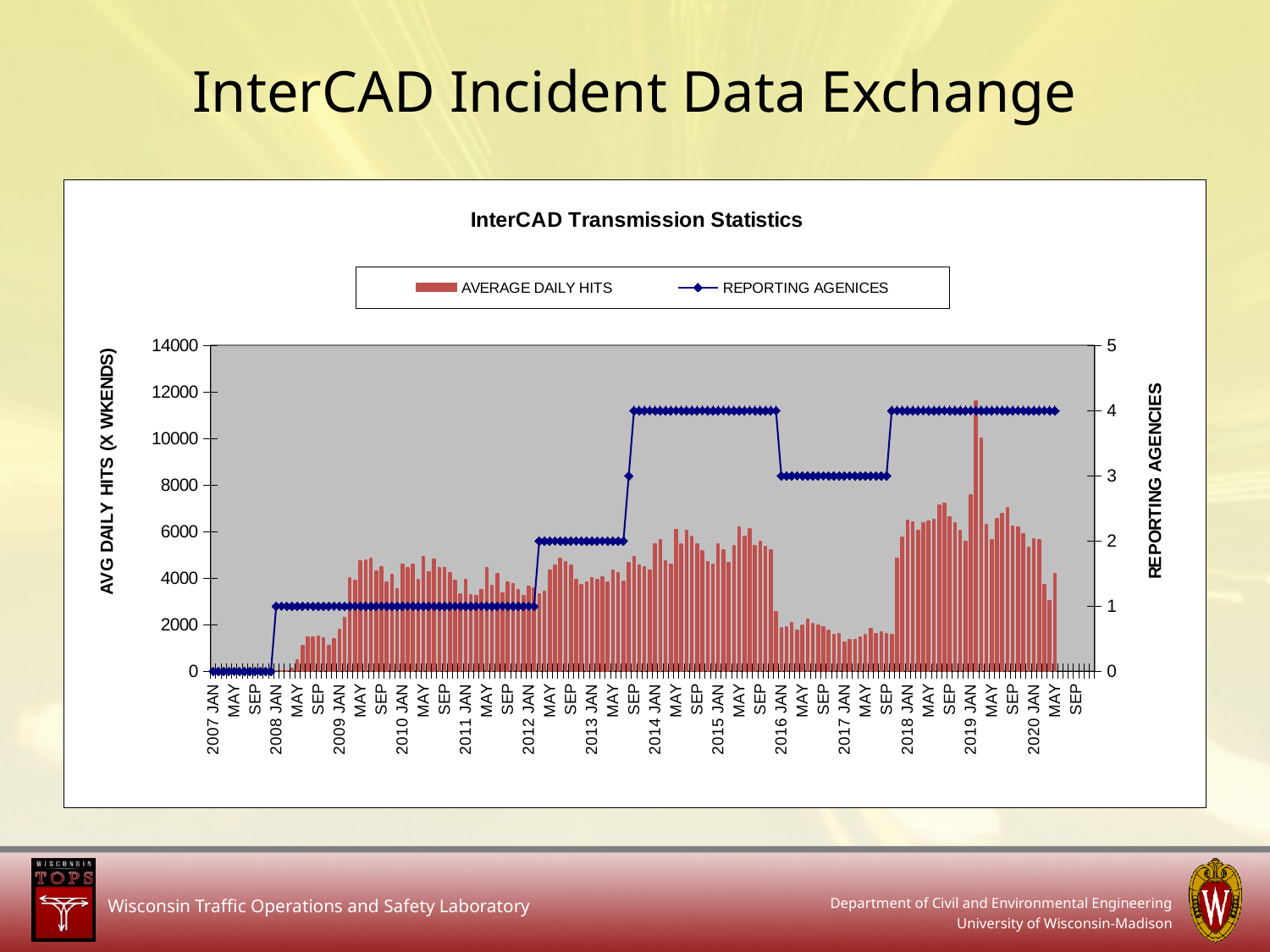
How many reporting agencies are shown for 2007 MAY? 0 Which period has more reporting agencies, 2014 MAY or 2016 SEP? 2014 MAY How many series does the legend of the InterCAD Transmission Statistics chart list? 2 How many reporting agencies are shown for 2014 JAN? 4 Is the highest average daily hits bar on the chart greater or less than 10000? greater What is the title of the left vertical axis on the chart? AVG DAILY HITS (X WKENDS) How many reporting agencies are shown for 2010 JAN? 1 How many reporting agencies are shown for 2016 MAY? 3 What are the two series named in the legend of the InterCAD Transmission Statistics chart? AVERAGE DAILY HITS and REPORTING AGENICES Is the average daily hits value for 2017 JAN greater or less than 2000? less What is the highest number of reporting agencies reached on the chart? 4 What kind of chart is the InterCAD Transmission Statistics chart? A combination bar and line chart